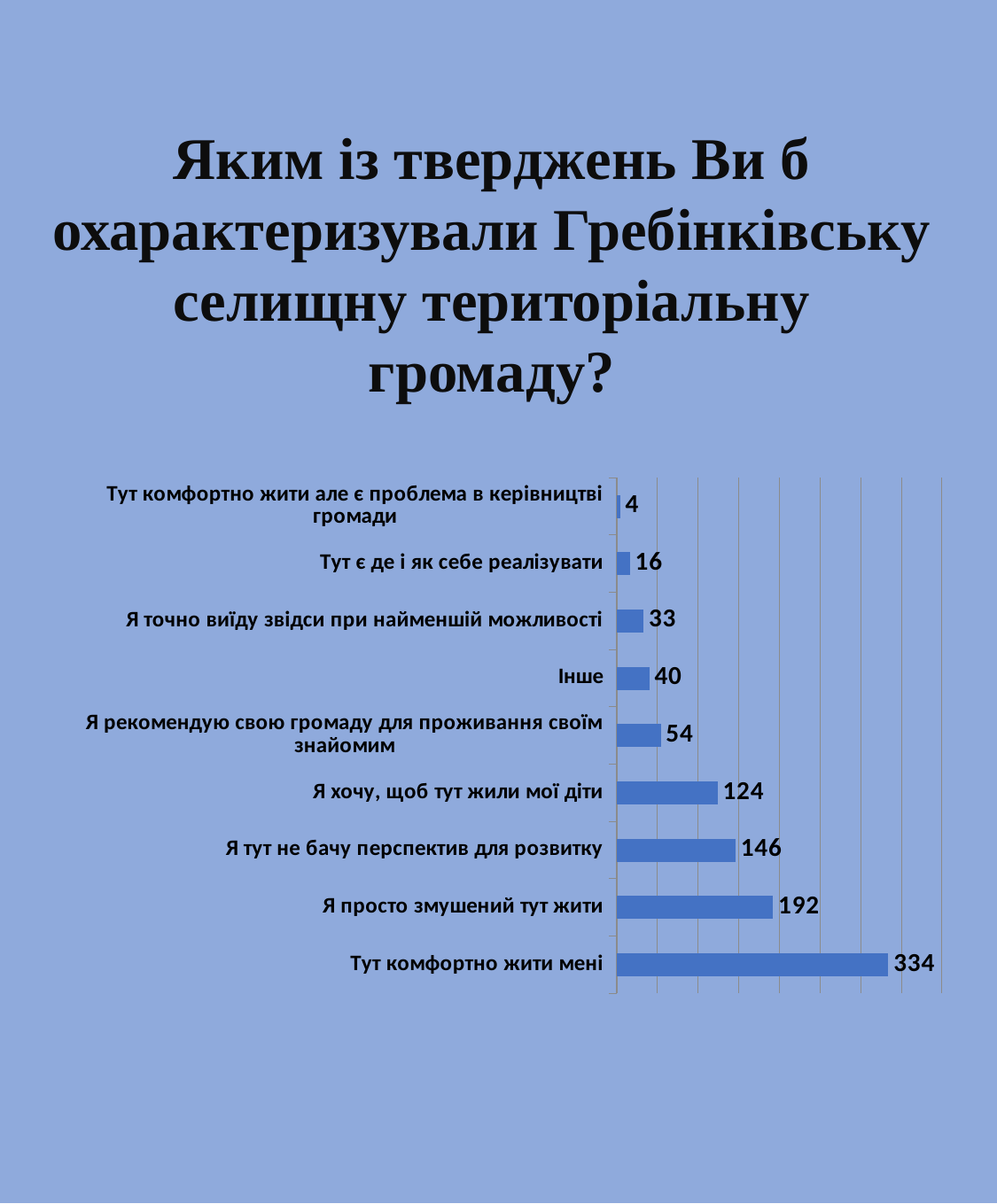
Which category has the highest value? Тут комфортно жити мені Which category has the lowest value? Тут комфортно жити але є проблема в керівництві громади What is the difference between the values for "Я просто змушений тут жити" and "Я тут не бачу перспектив для розвитку"? 46 What value is shown for "Я хочу, щоб тут жили мої діти"? 124 What value is shown for "Я просто змушений тут жити"? 192 What value is shown for "Інше"? 40 How many categories are shown in the chart? 9 What is the title of the slide above the chart? Яким із тверджень Ви б охарактеризували Гребінківську селищну територіальну громаду? What value is shown for "Тут комфортно жити мені"? 334 Which is larger: the value for "Я точно виїду звідси при найменшій можливості" or the value for "Я рекомендую свою громаду для проживання своїм знайомим"? Я рекомендую свою громаду для проживання своїм знайомим What is the difference between the values for "Тут комфортно жити мені" and "Я просто змушений тут жити"? 142 What kind of chart is shown on the slide? Bar chart